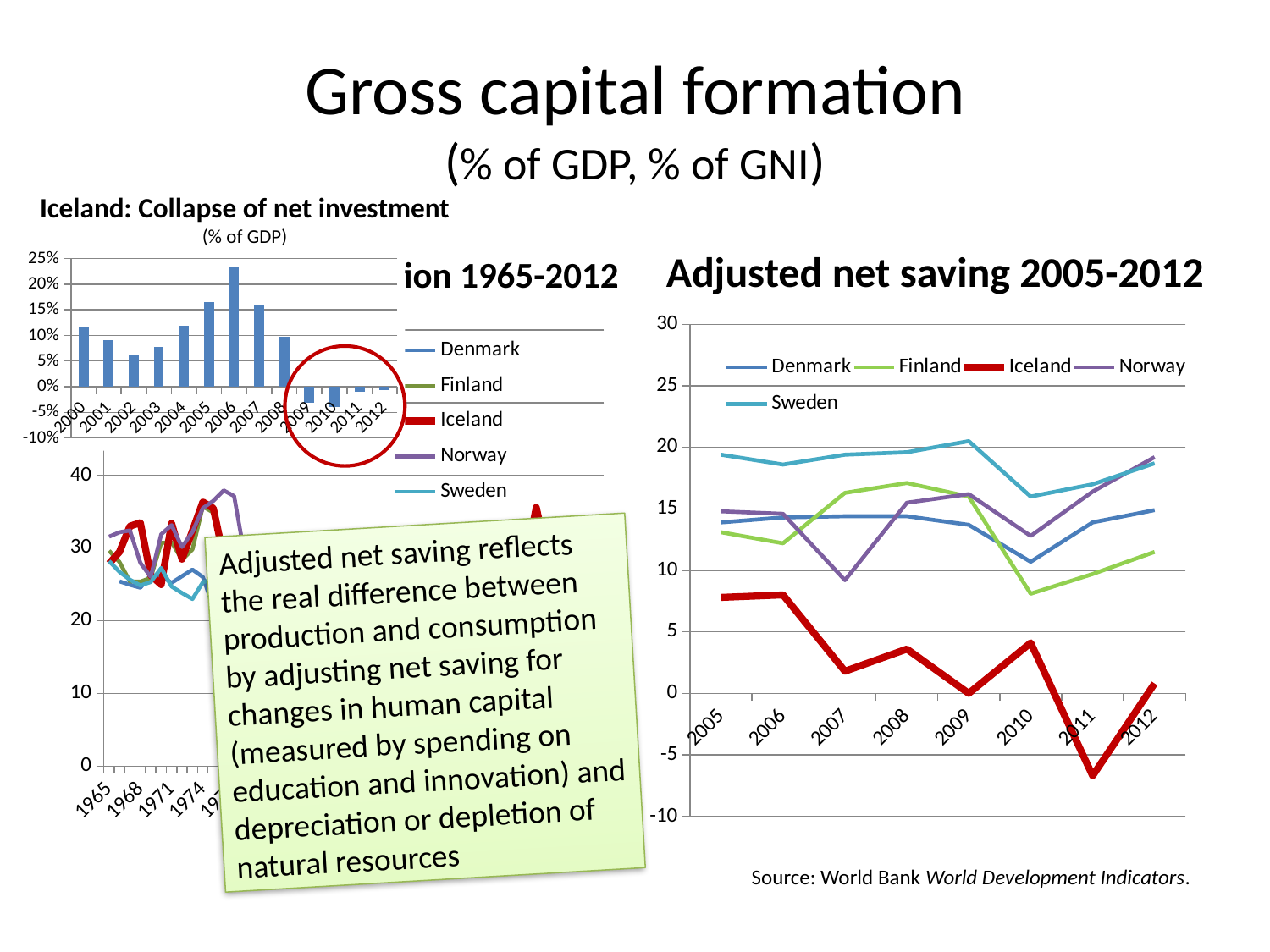
In the 'Adjusted net saving 2005-2012' chart, which country has the highest value in 2009? Sweden How many series does the legend of the 'Adjusted net saving 2005-2012' chart list? 5 What kind of chart is the 'Adjusted net saving 2005-2012' chart? Line chart In the 'Adjusted net saving 2005-2012' chart, which is larger in 2010: Sweden or Norway? Sweden In the 'Adjusted net saving 2005-2012' chart, is the value for Finland in 2010 greater or less than 10? less What kind of chart is the 'Iceland: Collapse of net investment' chart? Bar chart In the 'Adjusted net saving 2005-2012' chart, which is larger in 2008: Finland or Denmark? Finland In the 'Iceland: Collapse of net investment' chart, is the value for 2006 greater or less than 20%? greater In the 'Adjusted net saving 2005-2012' chart, is the value for Iceland in 2005 greater or less than 5? greater In the 'Adjusted net saving 2005-2012' chart, which country has the lowest value in 2011? Iceland In the 'Iceland: Collapse of net investment' chart, which year has the highest value? 2006